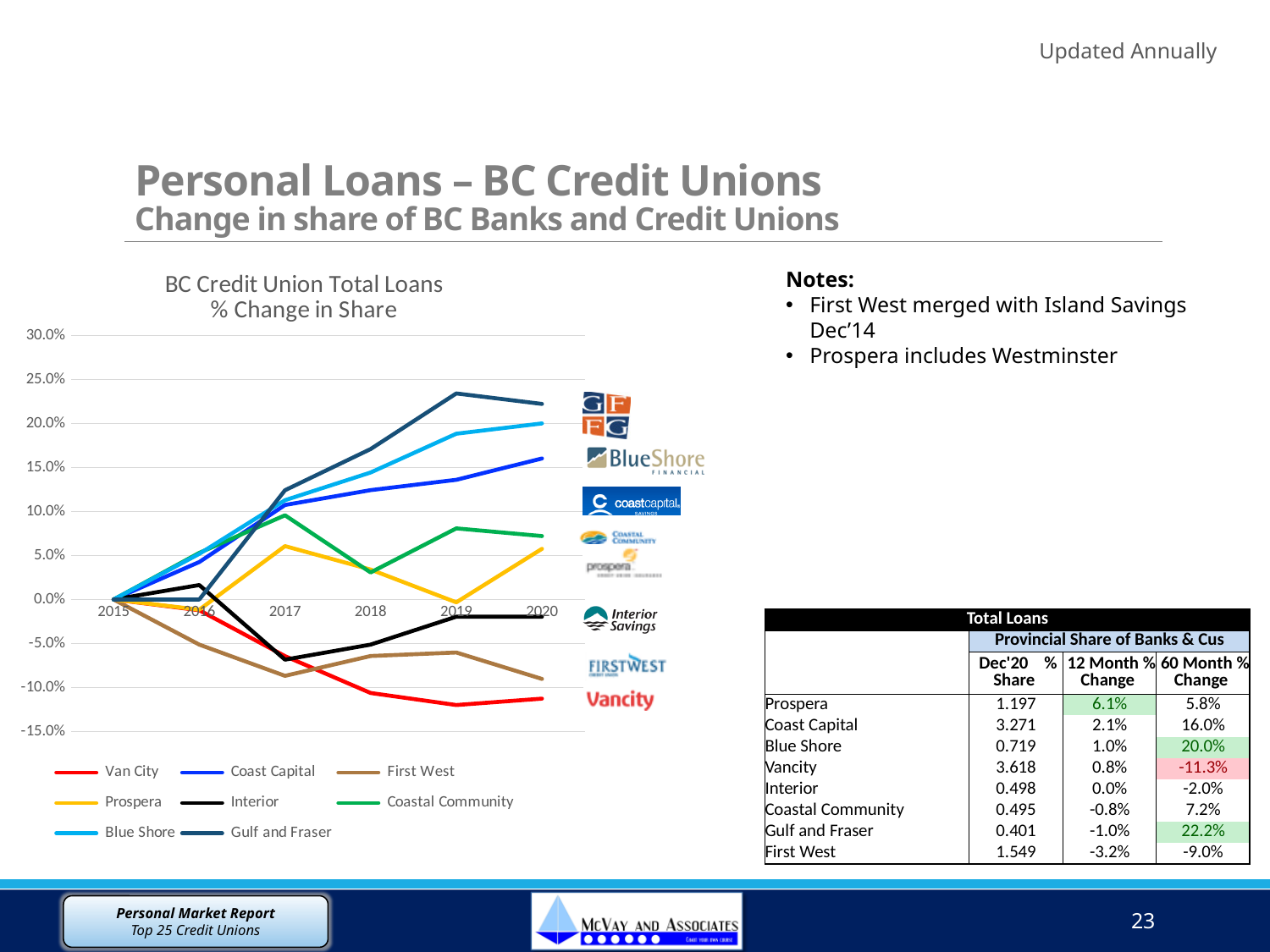
How many years are shown along the x axis of the chart? 6 Which series has the lowest value in 2020? Van City In 2019, which is larger: the value for Coastal Community or the value for Prospera? Coastal Community Is the value for Van City in 2020 greater or less than -10.0%? less Does the Gulf and Fraser line rise or fall from 2015 to 2019? rise In 2020, which is larger: the value for Interior or the value for First West? Interior What is the title of the chart? BC Credit Union Total Loans % Change in Share What type of chart is shown on the slide? line chart Is the value for Coast Capital in 2020 greater or less than 10.0%? greater Is the value for Gulf and Fraser in 2019 greater or less than 20.0%? greater How many series does the chart legend list? 8 Which series has the highest value in 2020? Gulf and Fraser